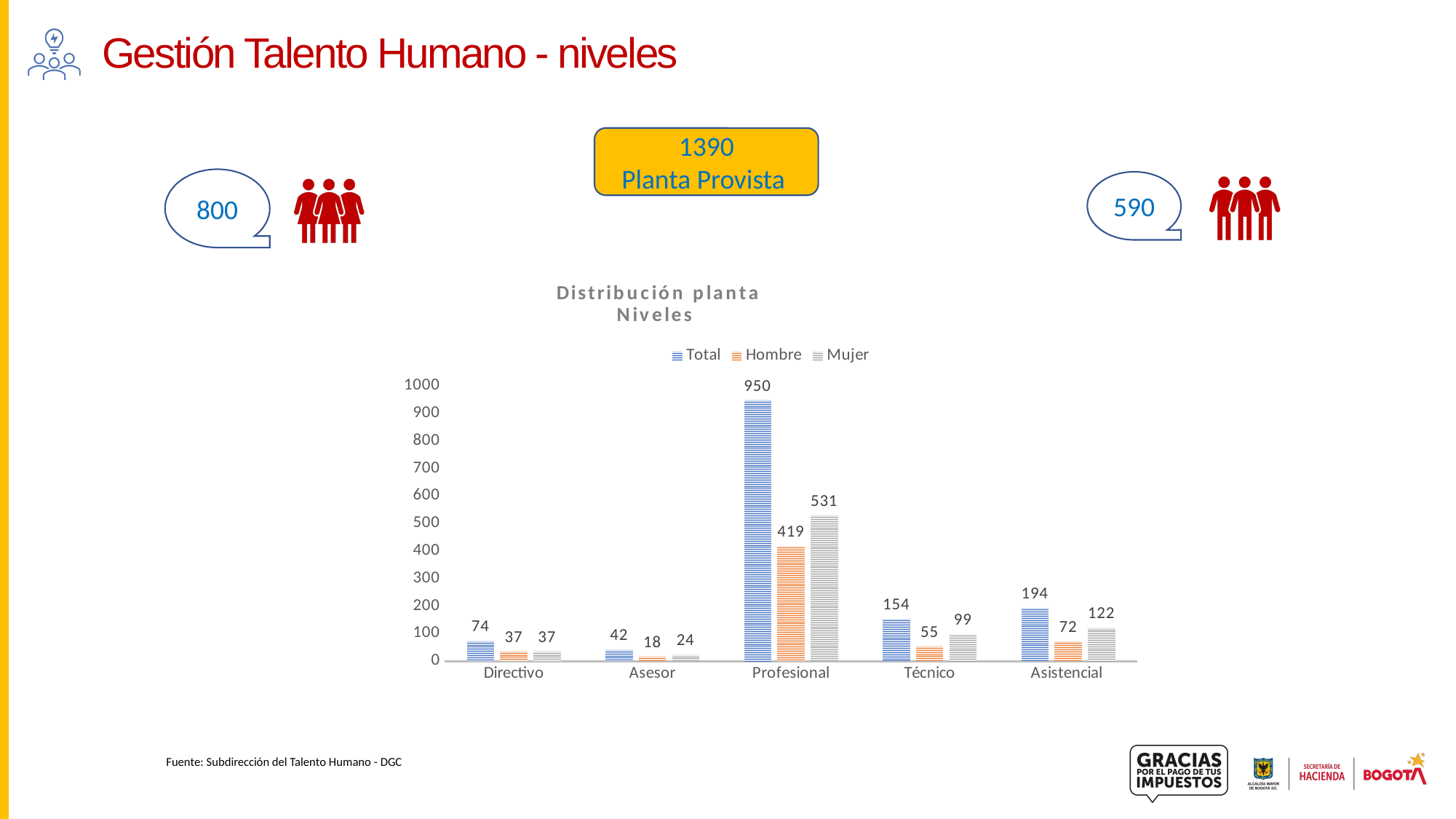
Which category has the highest Total value? Profesional What is the difference between the Mujer and Hombre values for Profesional? 112 What is the Mujer value for the Asistencial category? 122 What is the Total value for the Profesional category? 950 What is the title of the chart? Distribución planta Niveles How many categories are shown on the x axis? 5 Which category has the lowest Total value? Asesor Which is larger for Técnico, the Hombre value or the Mujer value? Mujer Is the Total value for Asistencial greater or less than 100? greater How many series does the legend list? 3 What kind of chart is shown on the slide? bar chart What is the Hombre value for the Asesor category? 18